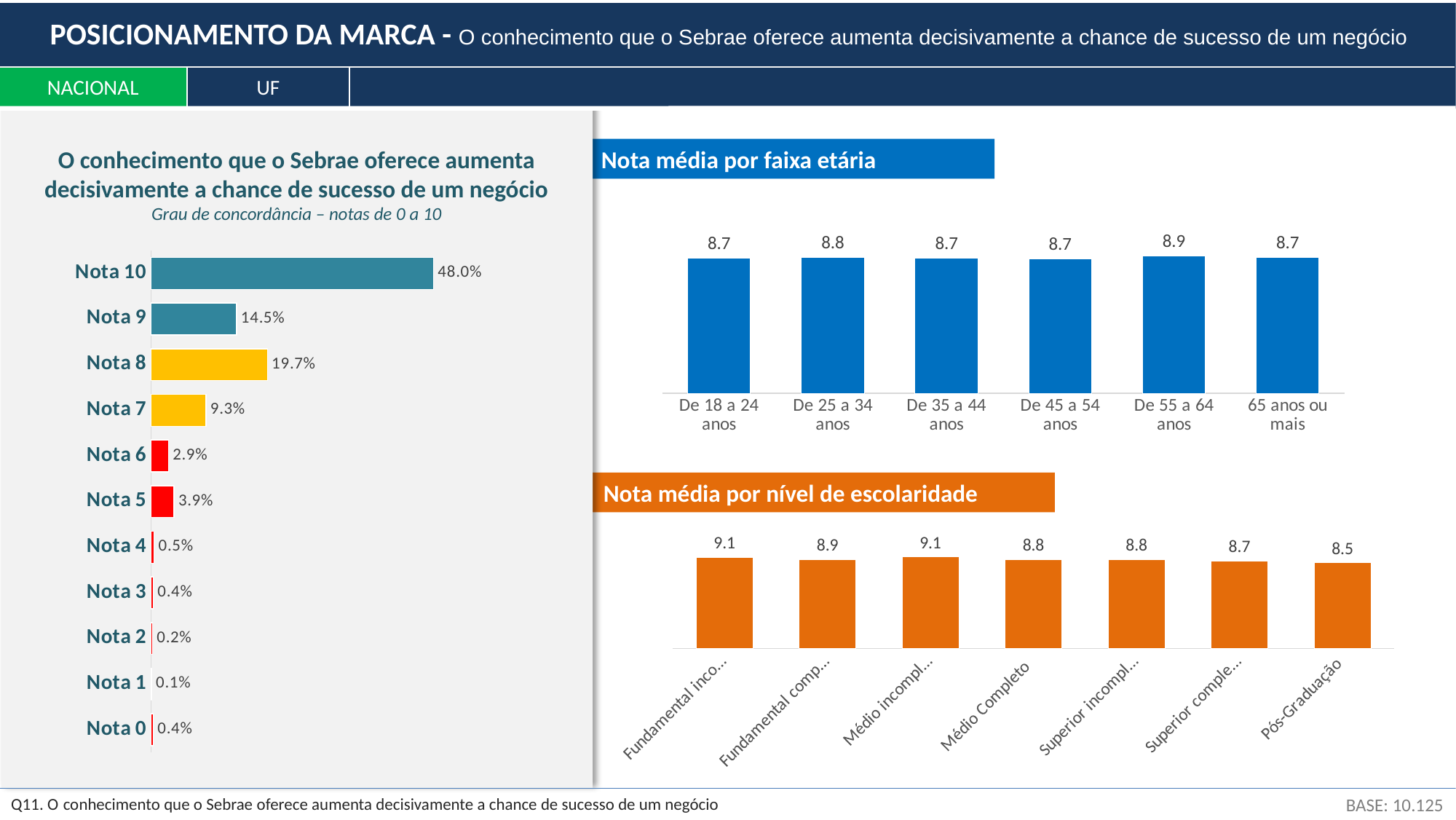
In the chart 'Nota média por faixa etária', what is the value for De 25 a 34 anos? 8.8 In the chart 'Nota média por nível de escolaridade', what is the value for Pós-Graduação? 8.5 In the chart 'Nota média por nível de escolaridade', what is the difference between the values for Médio Completo and Pós-Graduação? 0.3 In the left chart (Grau de concordância), what is the difference between the percentages for Nota 10 and Nota 9? 33.5% In the left chart (Grau de concordância), which is larger: the percentage for Nota 5 or for Nota 6? Nota 5 In the left chart (Grau de concordância), which Nota has the lowest percentage? Nota 1 In the left chart (Grau de concordância), what percentage is shown for Nota 8? 19.7% In the left chart (Grau de concordância), what percentage is shown for Nota 10? 48.0% In the left chart (Grau de concordância), which Nota has the highest percentage? Nota 10 In the left chart (Grau de concordância), how many Nota categories are shown? 11 In the chart 'Nota média por faixa etária', which age group has the highest value? De 55 a 64 anos What kind of chart is the left chart (Grau de concordância)? Bar chart